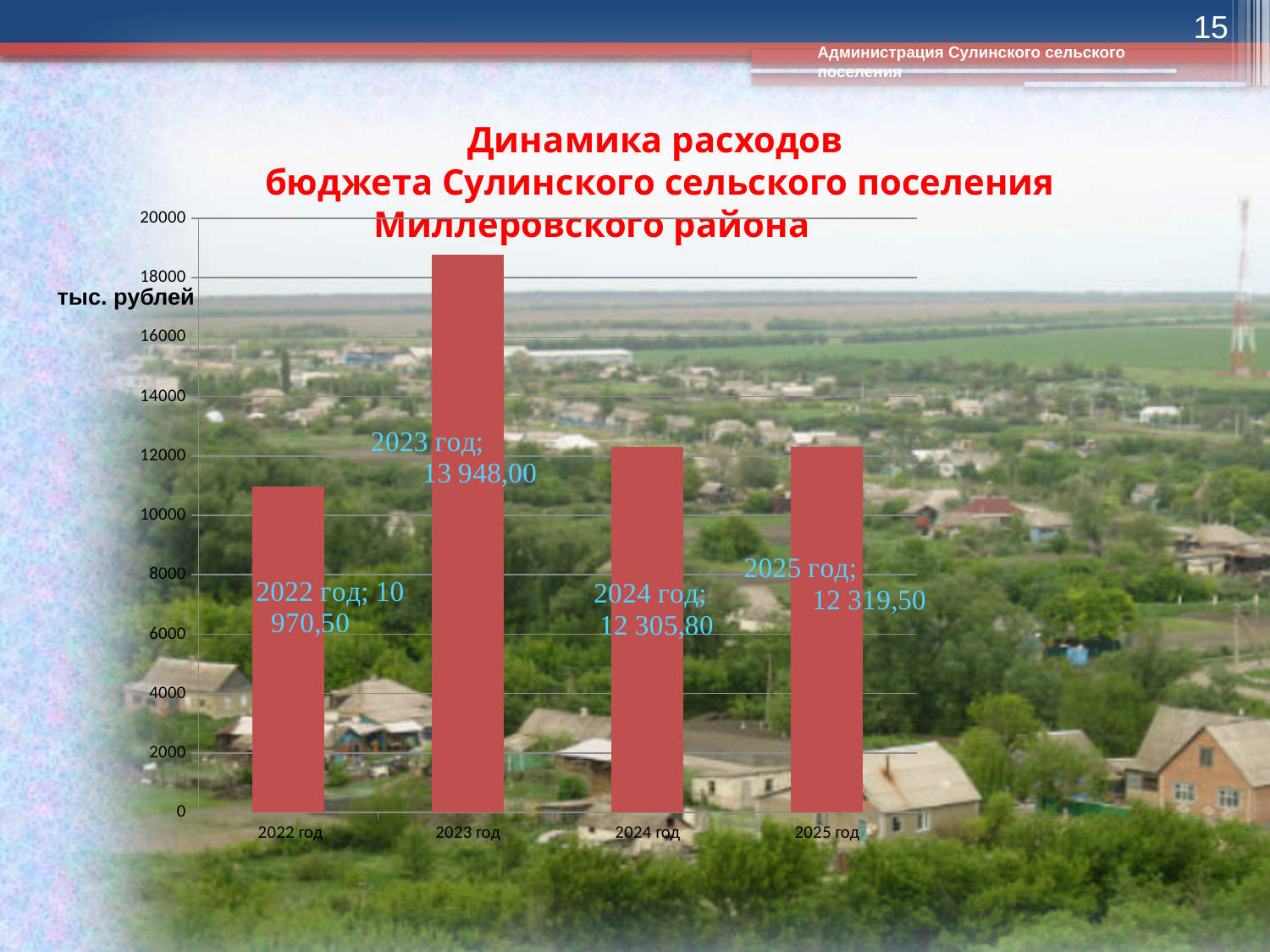
Which is larger, the value for 2023 год or the value for 2024 год? 2023 год What is the value for 2022 год? 10 970,50 Which year has the lowest value? 2022 год How many years (categories) are shown on the x axis? 4 What is the value for 2025 год? 12 319,50 Which year has the highest value? 2023 год Is the value for 2022 год greater or less than 12000? less What is the value for 2024 год? 12 305,80 What type of chart is shown on the slide? bar chart What unit is given on the vertical axis label? тыс. рублей